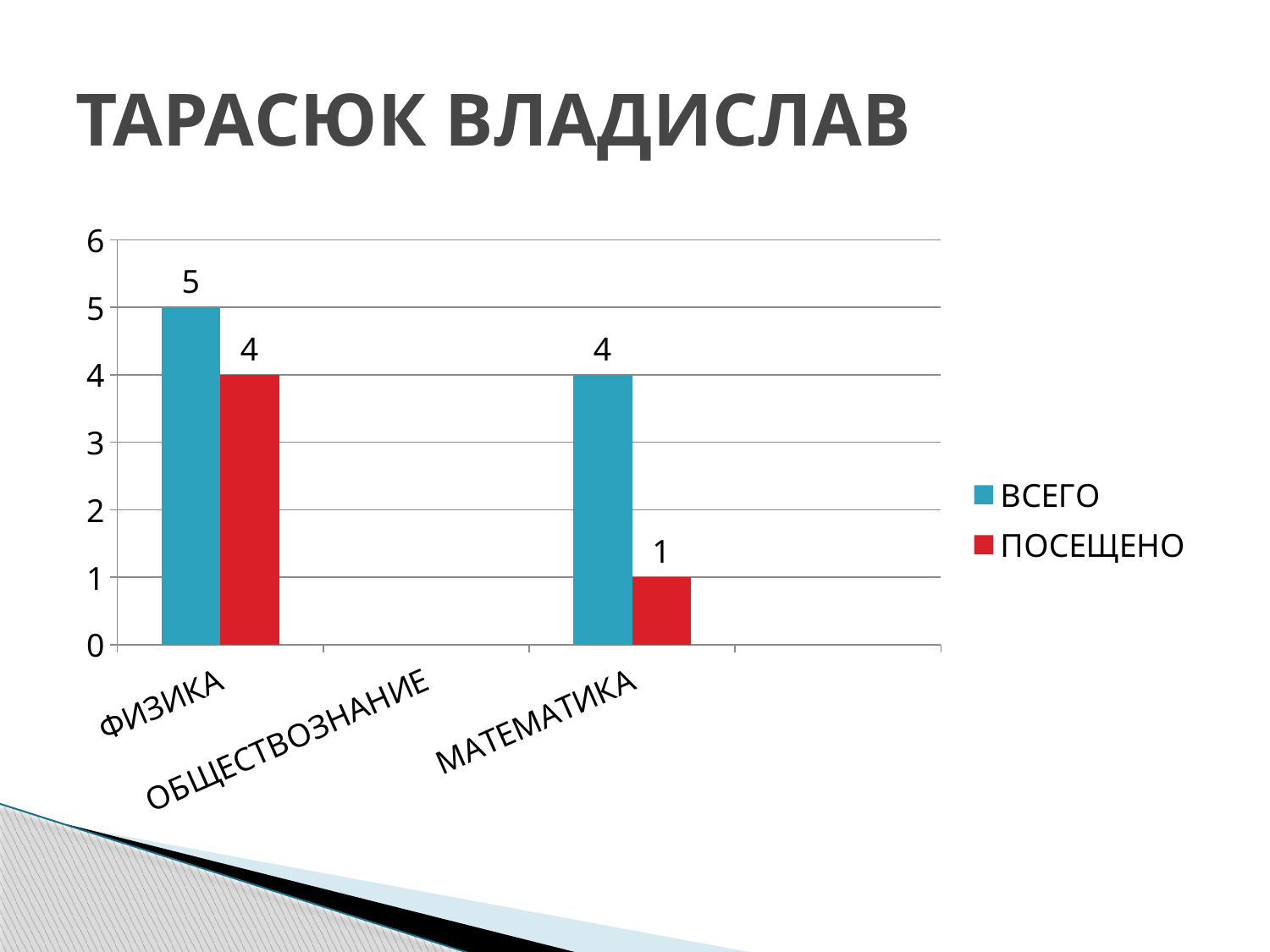
Which category has the highest ВСЕГО value? ФИЗИКА What is the ПОСЕЩЕНО value for МАТЕМАТИКА? 1 Which is larger: the ПОСЕЩЕНО value for ФИЗИКА or the ПОСЕЩЕНО value for МАТЕМАТИКА? ФИЗИКА What is the difference between the ВСЕГО and ПОСЕЩЕНО values for МАТЕМАТИКА? 3 What kind of chart is shown on the slide? Bar chart What is the ПОСЕЩЕНО value for ФИЗИКА? 4 What is the difference between the ПОСЕЩЕНО values for ФИЗИКА and МАТЕМАТИКА? 3 What is the ВСЕГО value for МАТЕМАТИКА? 4 What colour are the ПОСЕЩЕНО bars? Red Which category has the lowest ПОСЕЩЕНО value among those with bars? МАТЕМАТИКА What is the ВСЕГО value for ФИЗИКА? 5 How many series does the legend list? 2